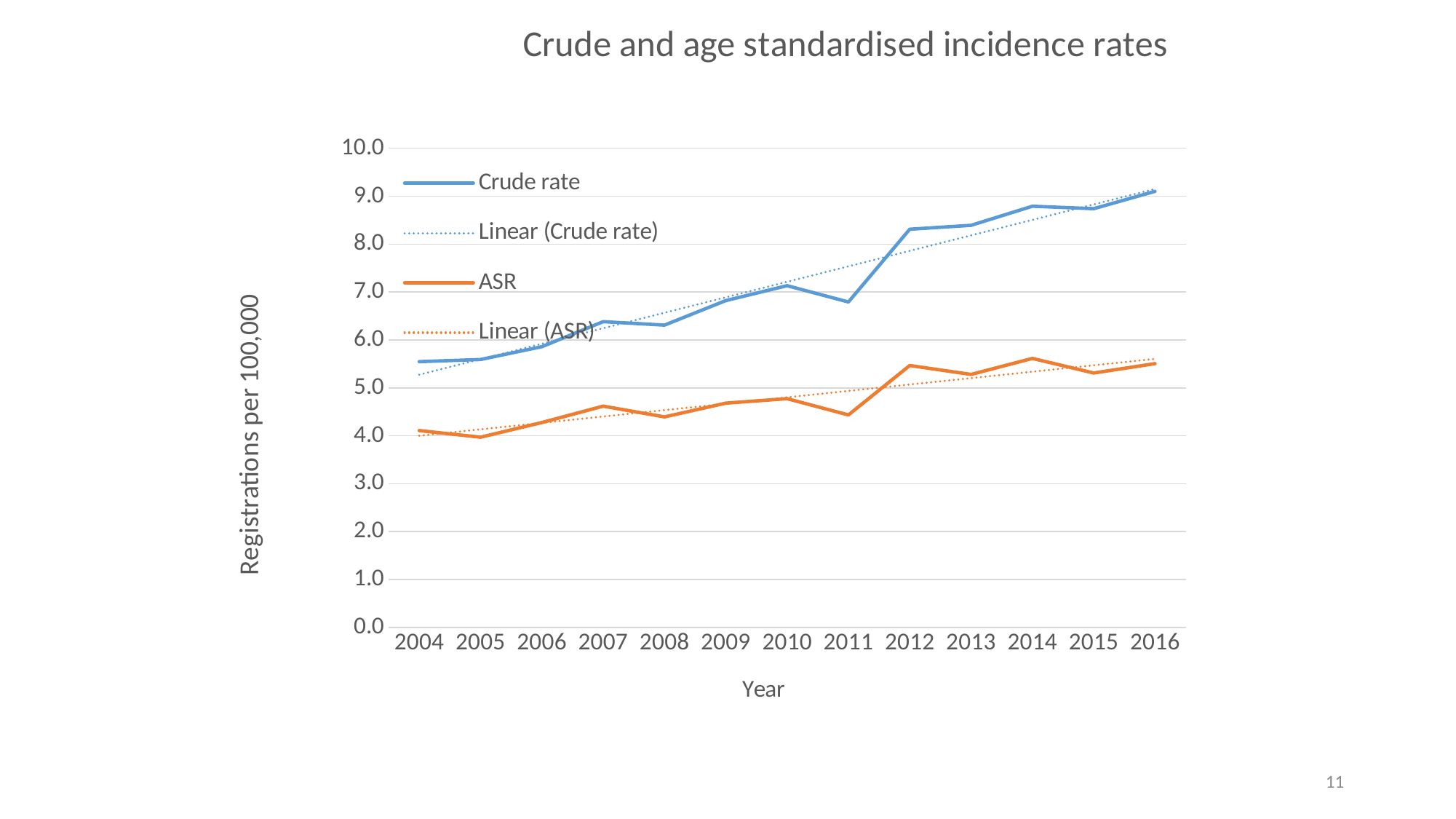
Is the ASR value for 2012 greater or less than 5.0? greater What is the label on the vertical axis of the chart? Registrations per 100,000 How many entries does the chart's legend list? 4 Which year has the highest Crude rate? 2016 How many years are plotted along the x axis? 13 Is the ASR value for 2008 greater or less than 5.0? less Does the Crude rate generally rise or fall from 2004 to 2016? Rise Is the Crude rate for 2011 greater or less than 7.0? less Which is larger in 2010, the Crude rate or the ASR? Crude rate What is the title of the chart? Crude and age standardised incidence rates What kind of chart is shown on the slide? Line chart